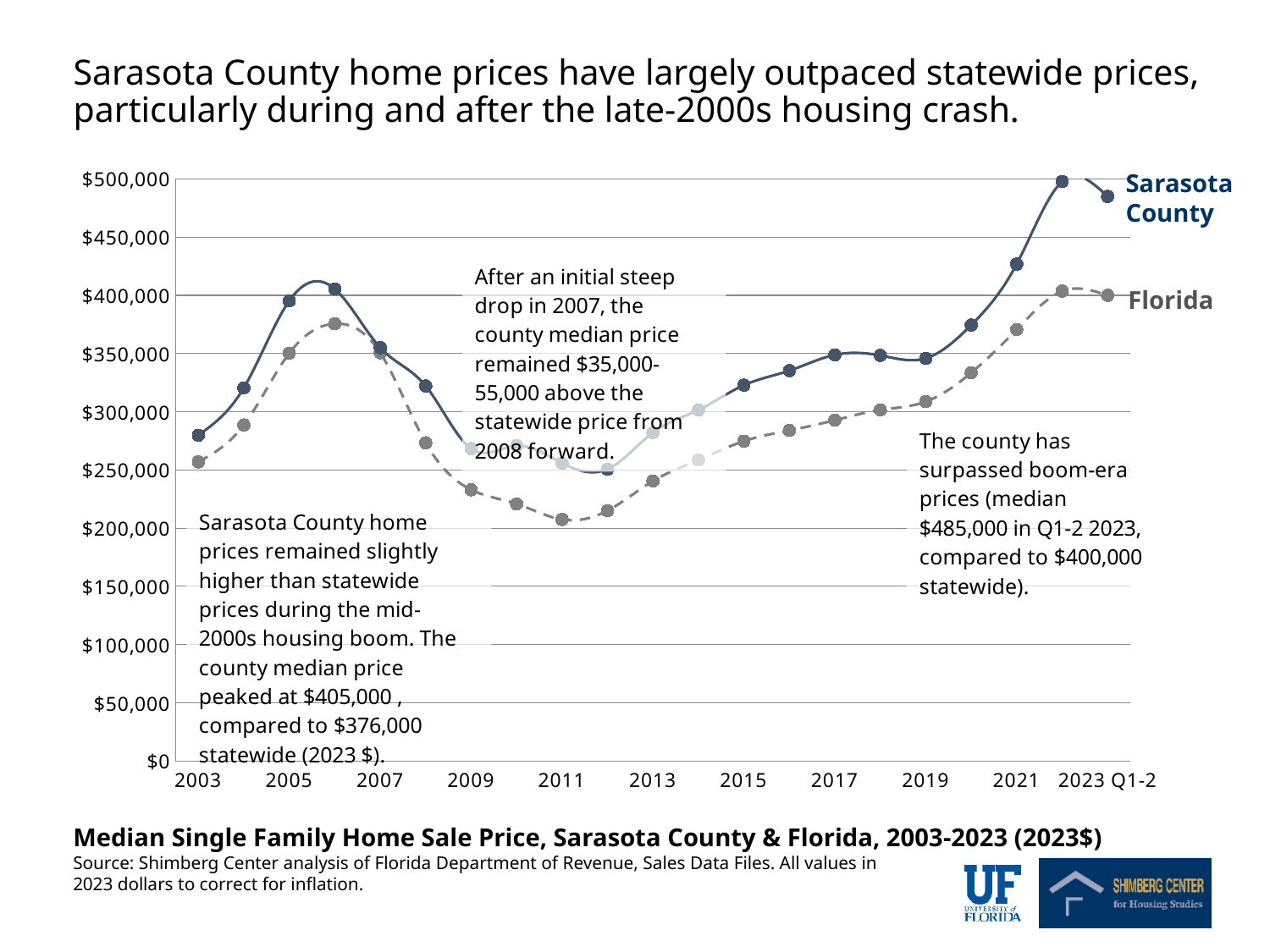
What kind of chart is shown on the slide? line chart How many data points does each line have along the x axis? 21 Is the Florida value for 2011 greater or less than $250,000? less In which year is the Florida line at its lowest? 2011 Which series has the higher value in 2011, Sarasota County or Florida? Sarasota County According to the annotation, what was the peak Sarasota County median price during the mid-2000s boom? $405,000 According to the annotation, what was the statewide median price in Q1-2 2023? $400,000 How many series are plotted on the chart? 2 Does the Sarasota County line rise or fall between 2011 and 2022? rise How much higher was the Sarasota County median price than the statewide price in Q1-2 2023, using the annotated values? $85,000 Is the Sarasota County value for 2022 greater or less than $450,000? greater According to the annotation, what was the Sarasota County median price in Q1-2 2023? $485,000